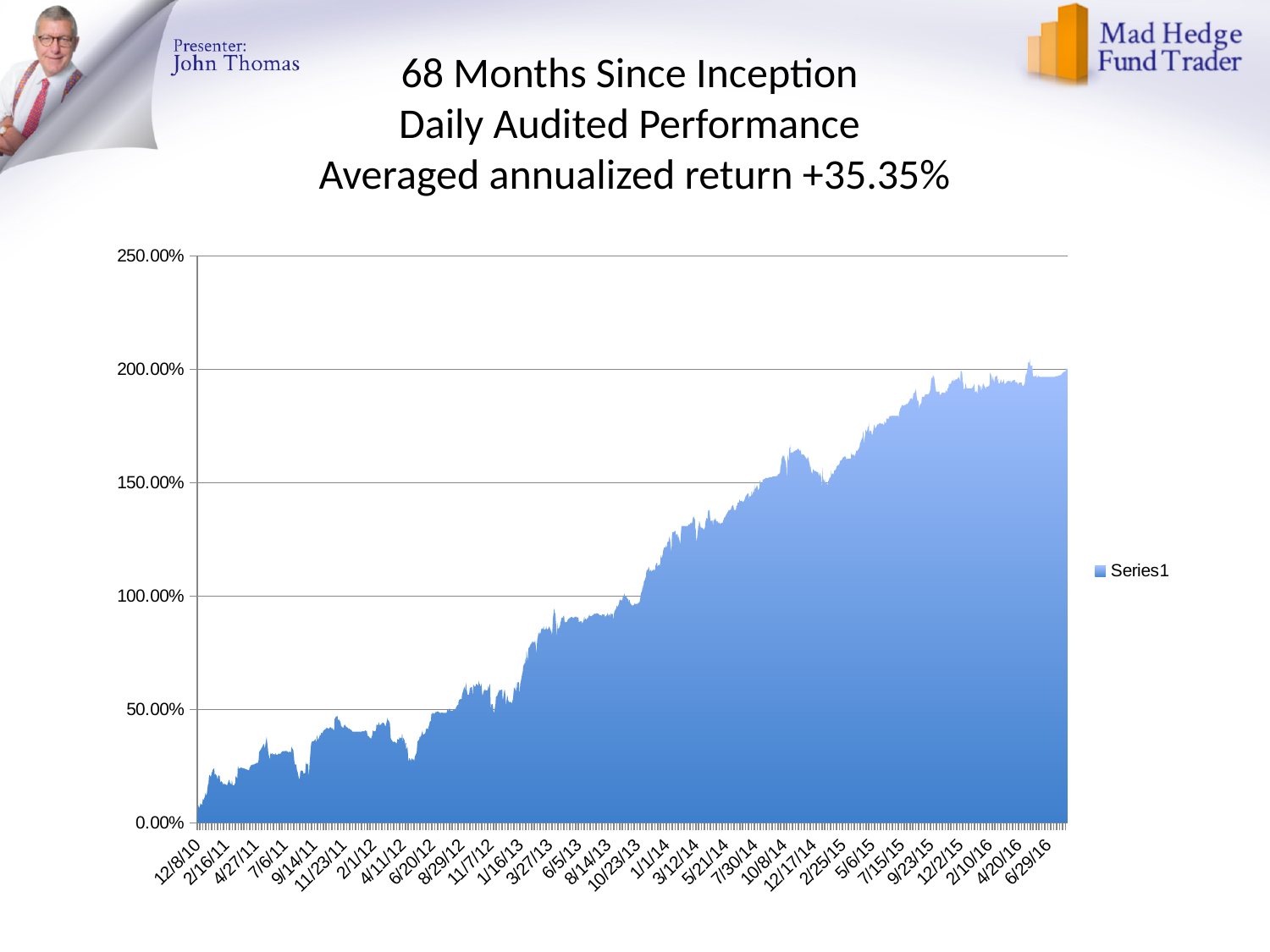
Is the value at 6/29/16 greater or less than 150.00%? greater How many series does the legend list? 1 Is the value at 6/29/16 greater or less than 250.00%? less What kind of chart is shown on the slide? area chart What averaged annualized return is stated in the chart title? +35.35% Do the values generally rise or fall from 12/8/10 to 6/29/16? rise Is the value at 12/8/10 greater or less than 50.00%? less What is the name of the series shown in the legend? Series1